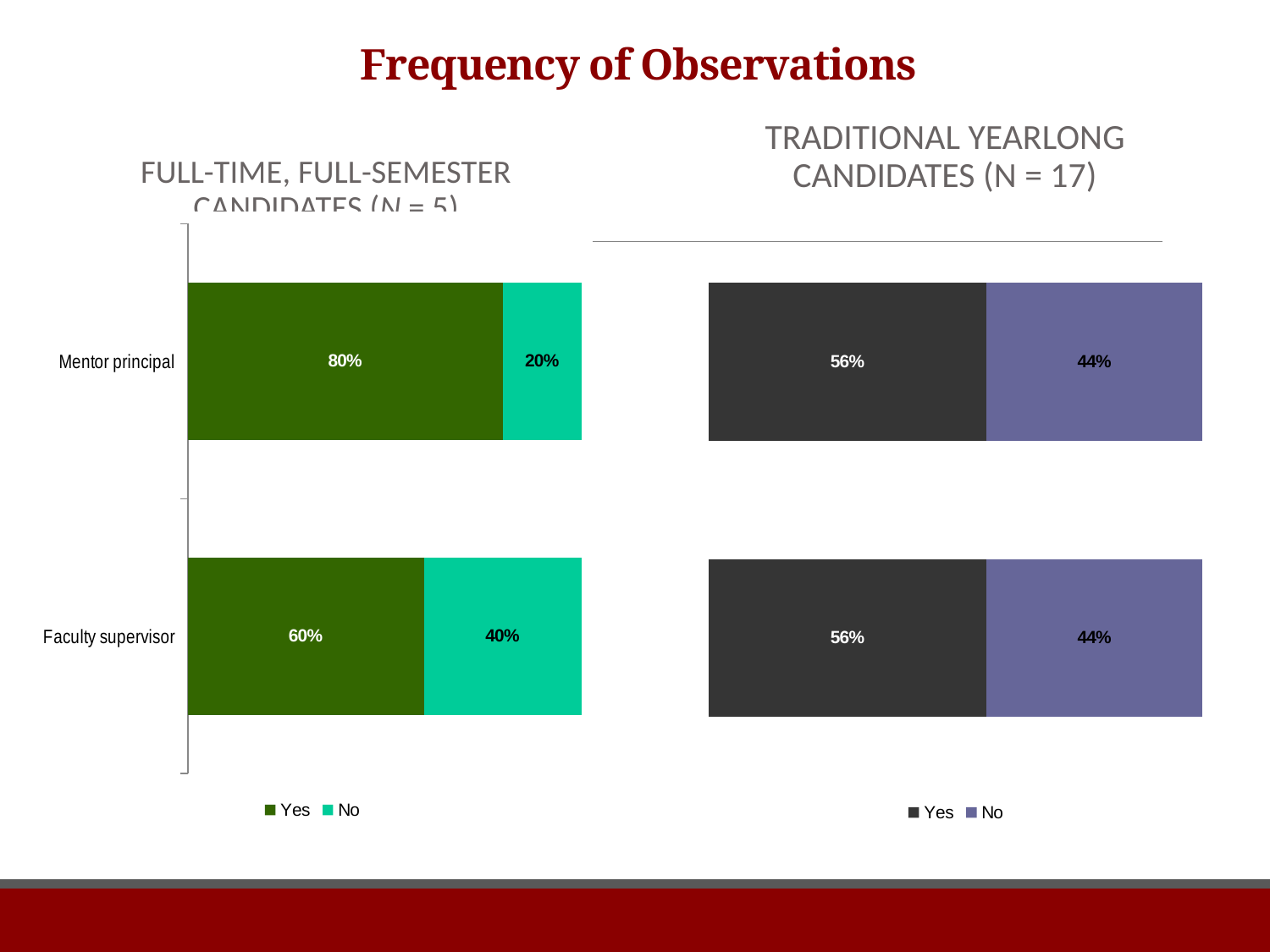
In the Full-Time, Full-Semester Candidates chart, what is the No value for Faculty supervisor? 40% In the Full-Time, Full-Semester Candidates chart, what is the difference between the Yes values for Mentor principal and Faculty supervisor? 20% In the Full-Time, Full-Semester Candidates chart, which category has the lowest No value? Mentor principal In the Full-Time, Full-Semester Candidates chart, what is the total of the stacked bar for Faculty supervisor? 100% How many categories are shown in the Traditional Yearlong Candidates chart? 2 In the Full-Time, Full-Semester Candidates chart, what is the Yes value for Mentor principal? 80% In the Traditional Yearlong Candidates chart, what is the No value for Faculty supervisor? 44% In the Traditional Yearlong Candidates chart, is the Yes value for Faculty supervisor larger or smaller than the No value for Faculty supervisor? larger In the Full-Time, Full-Semester Candidates chart, which category has the highest Yes value? Mentor principal In the Traditional Yearlong Candidates chart, what is the Yes value for Mentor principal? 56% How many series does the legend of the Full-Time, Full-Semester Candidates chart list? 2 What kind of chart is the Traditional Yearlong Candidates chart? Stacked bar chart